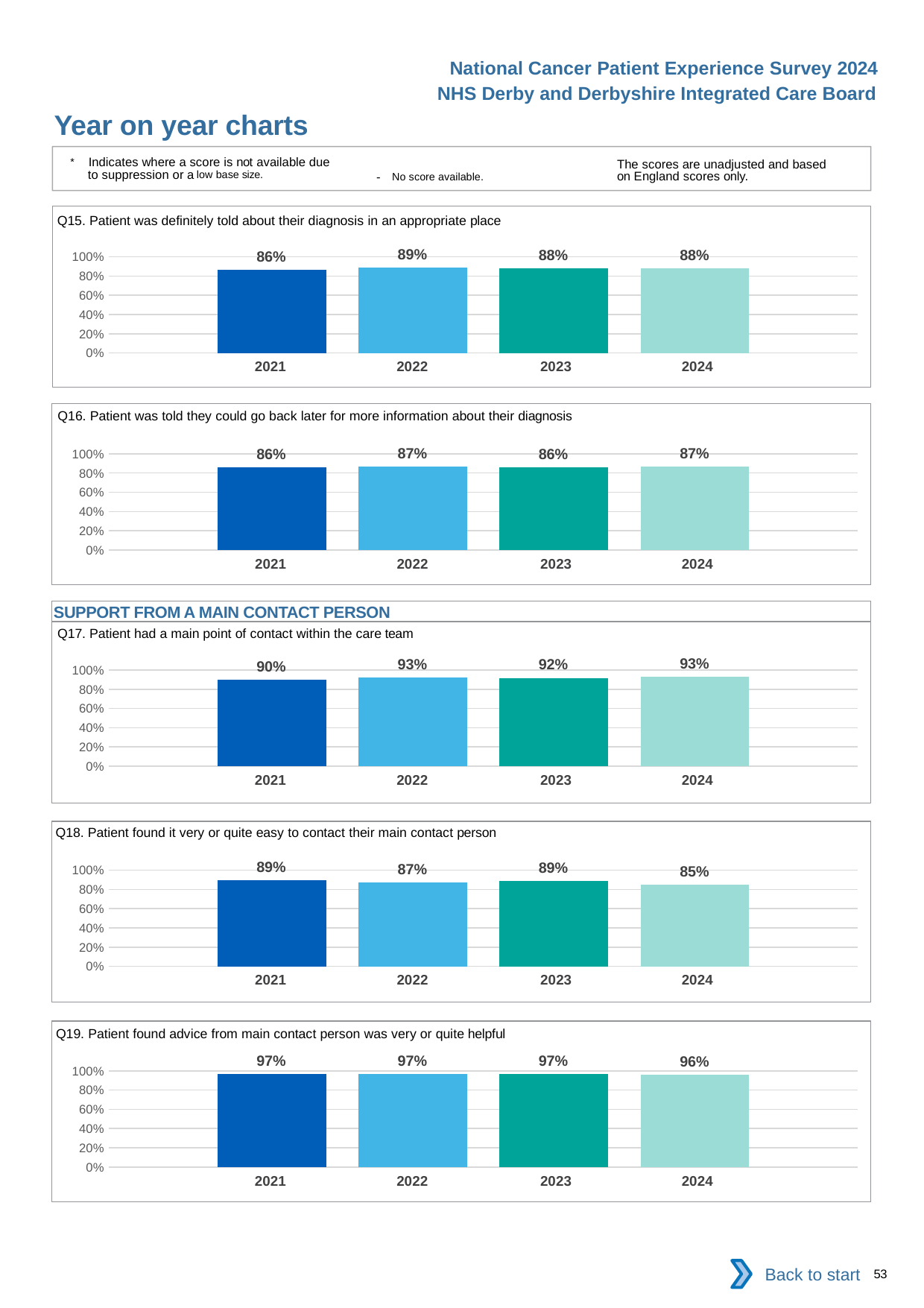
In the Q16 chart (patient was told they could go back later for more information about their diagnosis), what is the value for 2024? 87% In the Q18 chart (patient found it very or quite easy to contact their main contact person), which year has the lowest value? 2024 In the Q17 chart, what is the difference between the 2022 value and the 2021 value? 3 percentage points In the Q18 chart, is the value for 2024 greater or less than 80%? greater What type of chart is the Q15 chart? Bar chart In the Q18 chart, is the value for 2021 or 2022 larger? 2021 In the Q15 chart, which year has the lowest value? 2021 In the Q19 chart (patient found advice from main contact person was very or quite helpful), what is the value for 2024? 96% In the Q17 chart (patient had a main point of contact within the care team), what is the value for 2021? 90% In the Q16 chart, how many years are plotted? 4 In the Q19 chart, what is the difference between the 2023 value and the 2024 value? 1 percentage point In the Q15 chart (patient was definitely told about their diagnosis in an appropriate place), what is the value for 2022? 89%